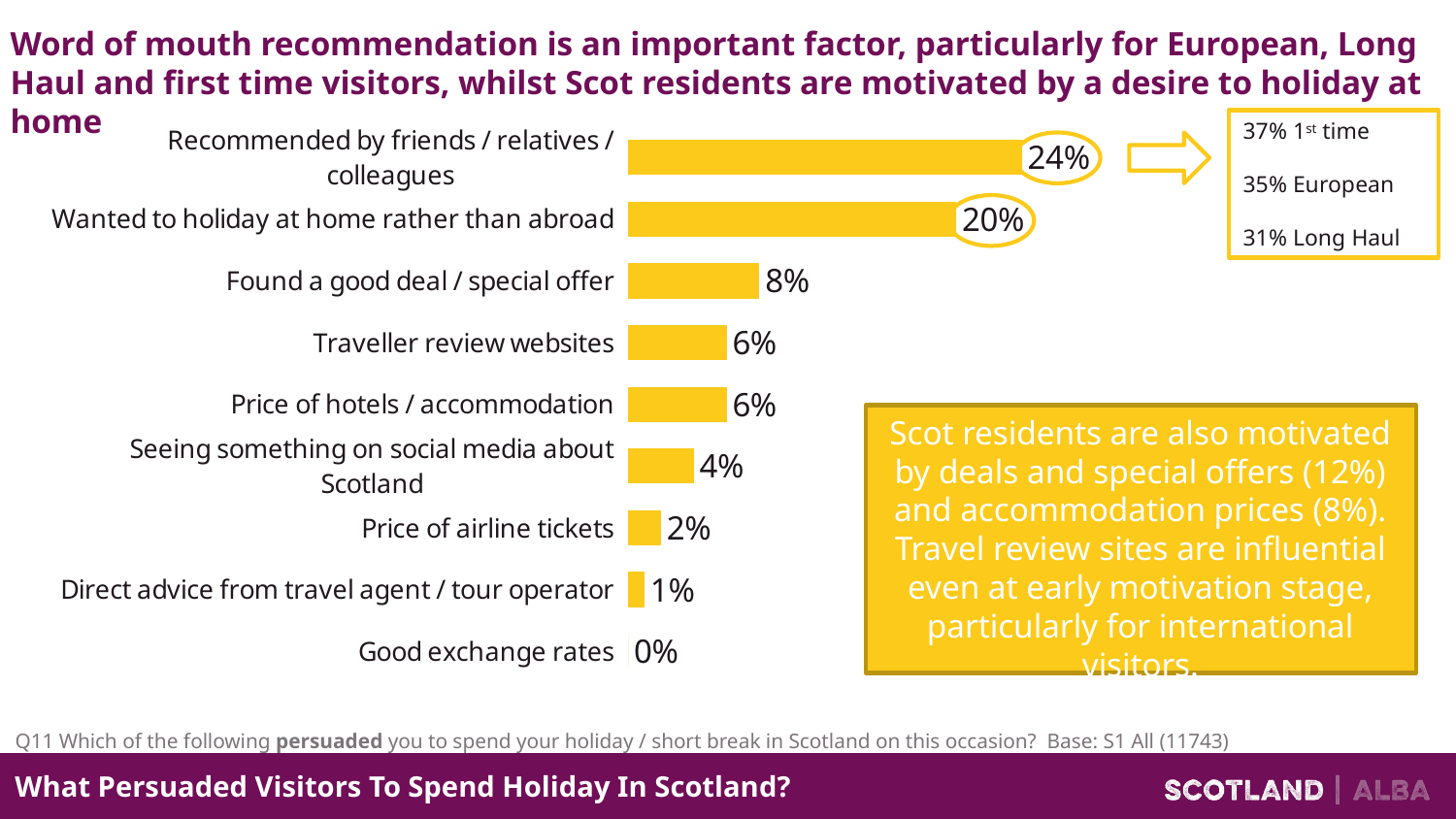
What is the value for 'Price of airline tickets'? 2% How many categories are shown in the bar chart? 9 What is the difference between 'Found a good deal / special offer' and 'Price of hotels / accommodation'? 2% What is the difference between 'Recommended by friends / relatives / colleagues' and 'Wanted to holiday at home rather than abroad'? 4% What type of chart is shown on the slide? Bar chart What percentage of visitors cited traveller review websites? 6% Which category has the highest value in the chart? Recommended by friends / relatives / colleagues According to the callout box, what percentage of first time visitors were persuaded by word of mouth recommendation? 37% What percentage of visitors were persuaded by being recommended by friends / relatives / colleagues? 24% Which is larger: 'Found a good deal / special offer' or 'Seeing something on social media about Scotland'? Found a good deal / special offer What is the value for 'Wanted to holiday at home rather than abroad'? 20% Which category has the lowest value in the chart? Good exchange rates